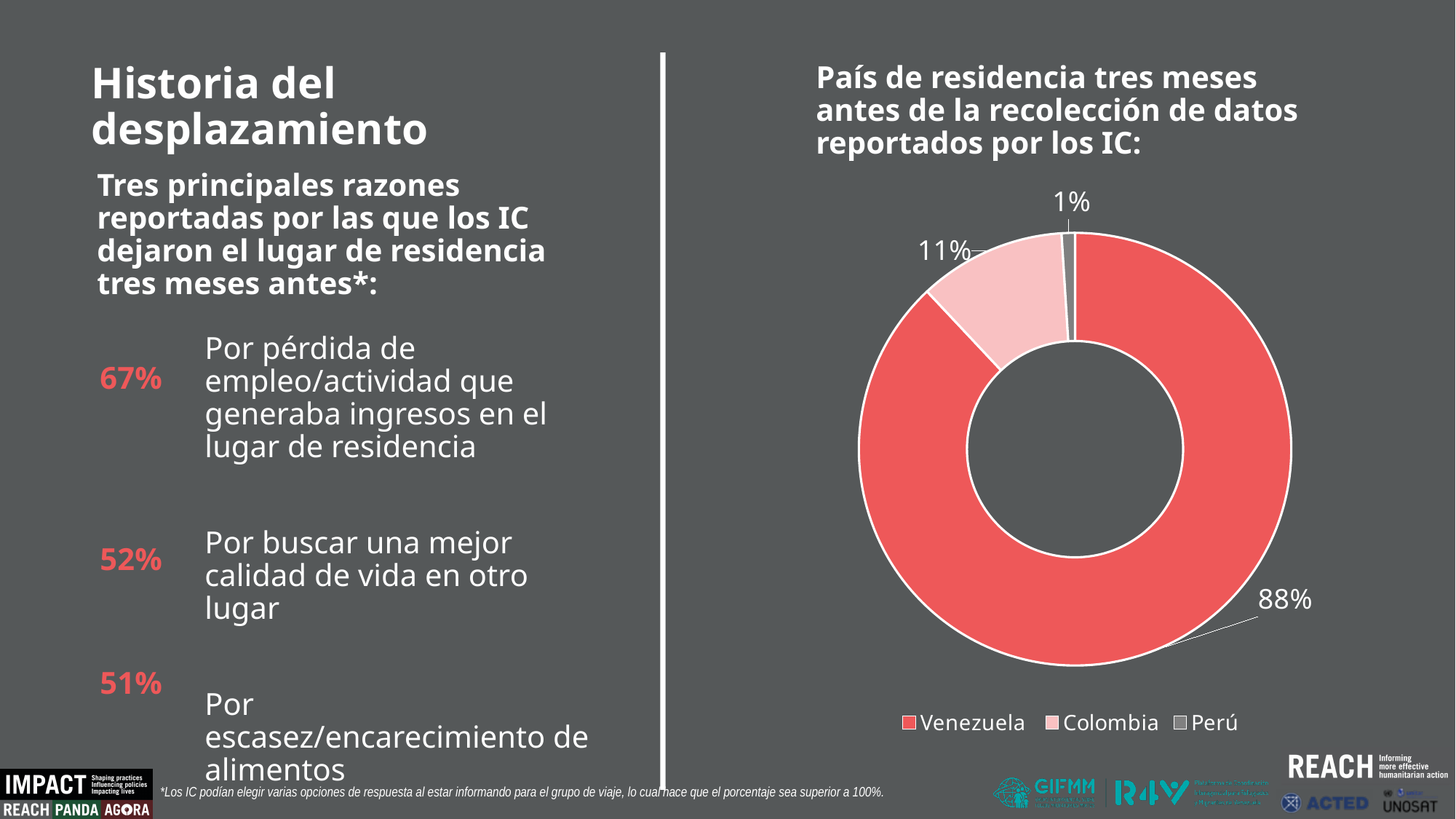
What is the difference in percentage points between the Venezuela and Colombia slices? 77 What type of chart is shown on the right side of the slide? Pie chart (doughnut) Which country has the smallest slice in the pie chart? Perú What share of the pie chart does Perú represent? 1% Which country has the largest slice in the pie chart? Venezuela What share of the pie chart does Venezuela represent? 88% How many entries does the legend of the pie chart list? 3 What share of the pie chart does Colombia represent? 11% How many countries are shown in the pie chart? 3 What is the title of the pie chart? País de residencia tres meses antes de la recolección de datos reportados por los IC: Which country is shown in the lightest pink colour in the pie chart? Colombia Which slice is larger, Colombia or Perú? Colombia